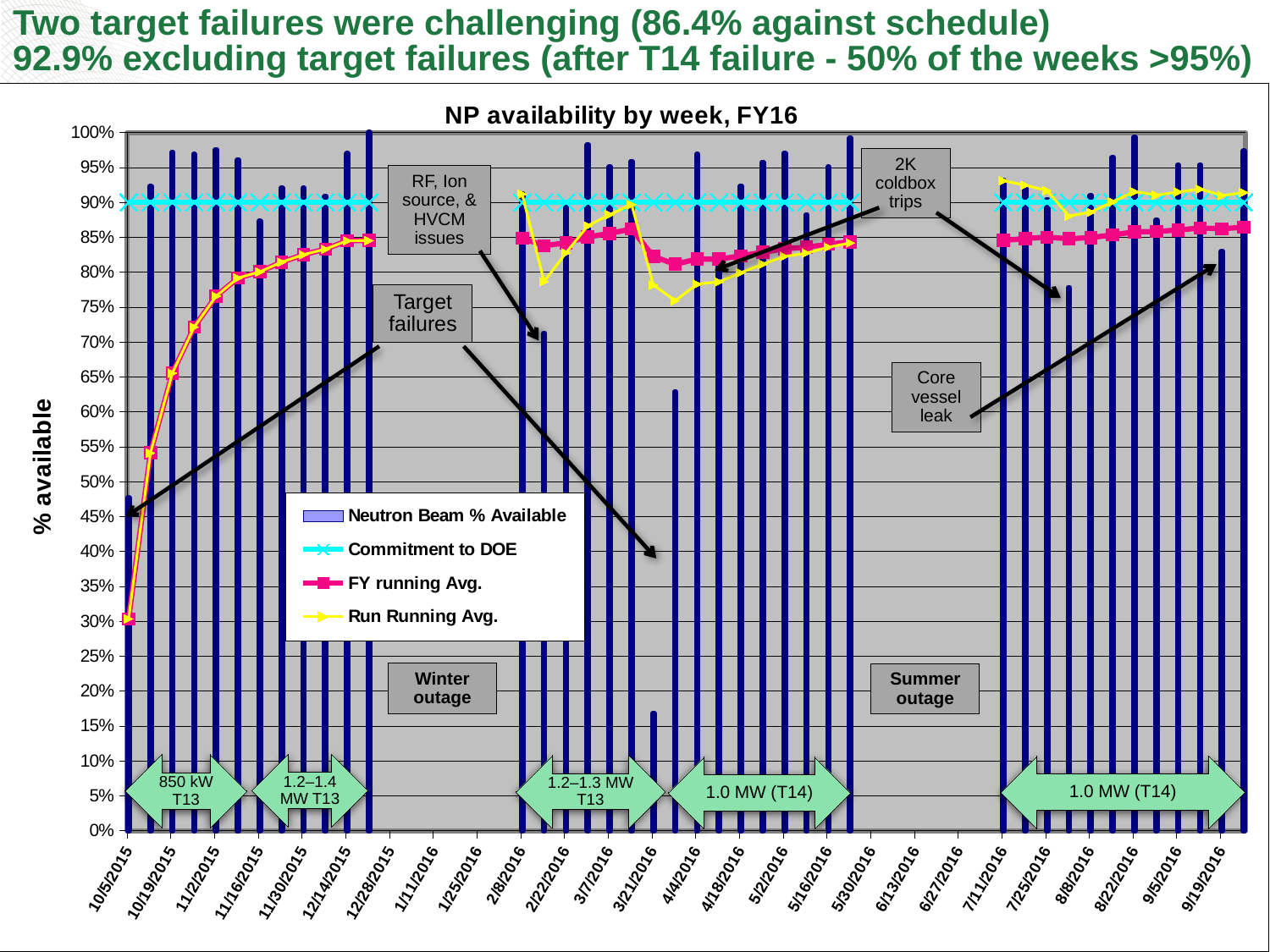
Is the Neutron Beam % Available value for 10/5/2015 greater or less than 60%? less At what value does the Commitment to DOE line sit throughout the chart? 90% What is the title of the chart? NP availability by week, FY16 Is the Neutron Beam % Available value for 3/21/2016 greater or less than 30%? less What is the label on the vertical axis? % available Is the FY running Avg value at 12/14/2015 greater or less than 80%? greater Does the FY running Avg rise or fall between 10/5/2015 and 12/14/2015? rise Which is larger at 10/5/2015: the Neutron Beam % Available bar or the FY running Avg point? Neutron Beam % Available bar Is the Run Running Avg value at 3/21/2016 greater or less than the Commitment to DOE line? less How many series does the legend list? 4 What kind of chart is used to show the Neutron Beam % Available series? bar chart